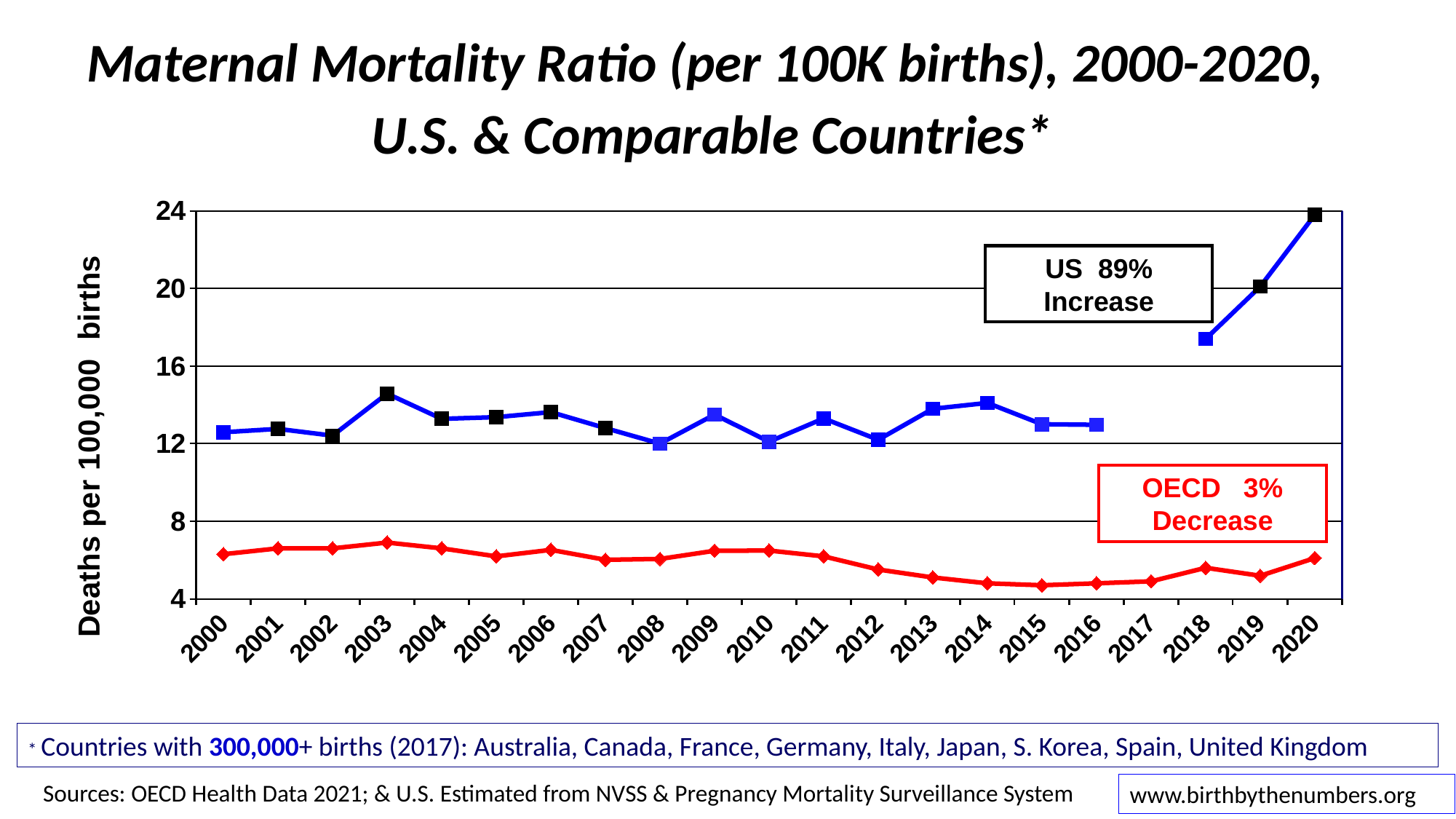
Does the US line rise or fall from 2016 to 2020? Rise Is the OECD value for 2003 greater or less than 8? less How many years are plotted along the x axis? 21 Is the US value for 2003 greater or less than 12? greater Which is larger in 2010, the US value or the OECD value? US What percentage change does the annotation box give for the US? 89% Increase What kind of chart is shown on the slide? Line chart In which year is the US maternal mortality ratio highest? 2020 How many data series are plotted on the chart? 2 Is the US value for 2020 greater or less than 20? greater What is the label on the y axis? Deaths per 100,000 births